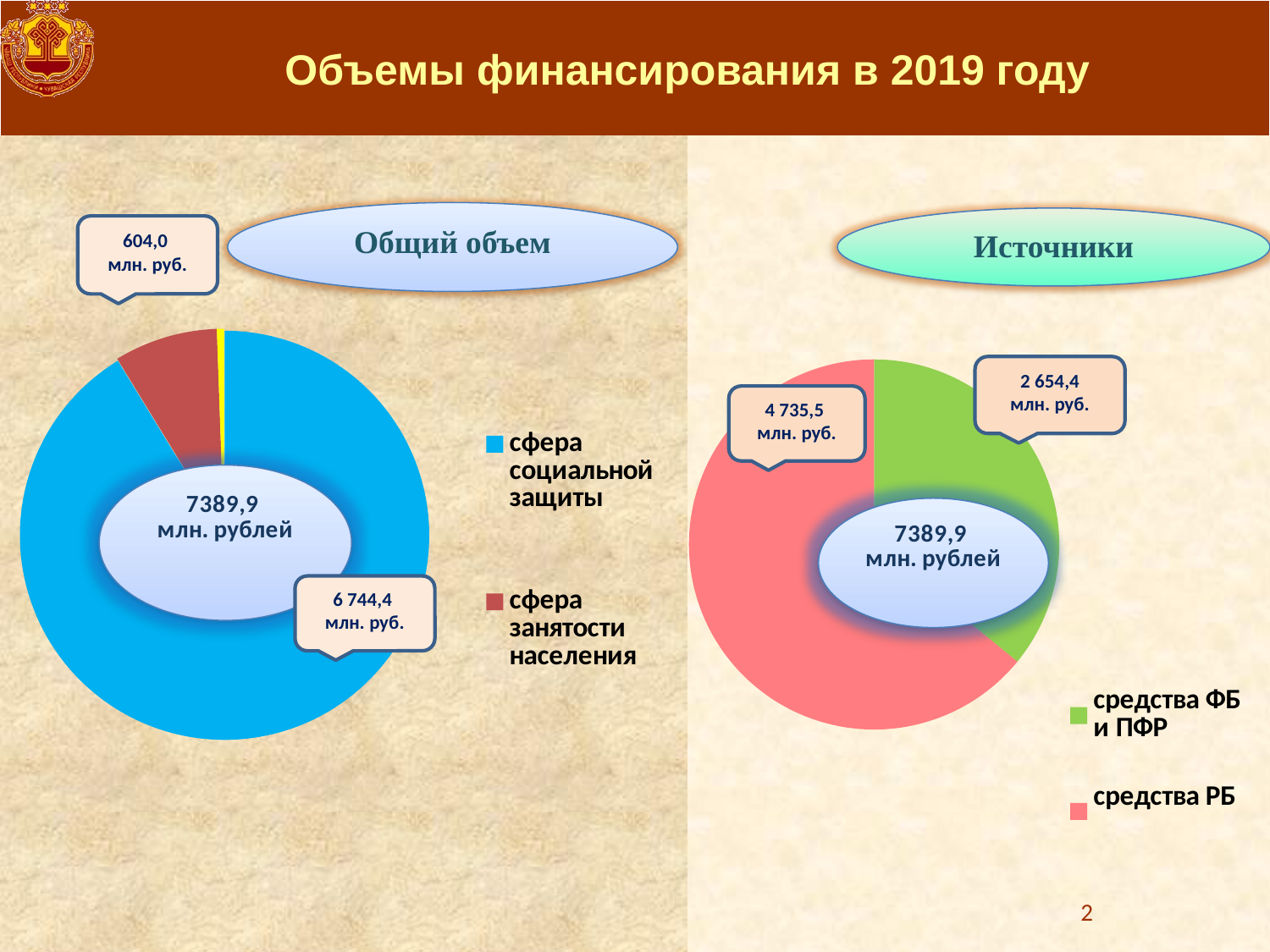
In the "Общий объем" chart, which category has the largest slice? сфера социальной защиты How many entries does the legend of the "Общий объем" chart list? 2 In the "Общий объем" chart, what is the value for сфера социальной защиты? 6 744,4 млн. руб. In the "Общий объем" chart, what total is shown in the centre of the pie? 7389,9 млн. рублей In the "Источники" chart, what is the value for средства ФБ и ПФР? 2 654,4 млн. руб. In the "Источники" chart, what is the value for средства РБ? 4 735,5 млн. руб. In the "Общий объем" chart, what is the difference between сфера социальной защиты and сфера занятости населения? 6 140,4 млн. руб. In the "Источники" chart, what is the difference between средства РБ and средства ФБ и ПФР? 2 081,1 млн. руб. What kind of chart is used on the left under "Общий объем"? pie chart In the "Общий объем" chart, what is the value for сфера занятости населения? 604,0 млн. руб. In the "Источники" chart, how many slices does the pie have? 2 In the "Источники" chart, which source is larger: средства РБ or средства ФБ и ПФР? средства РБ